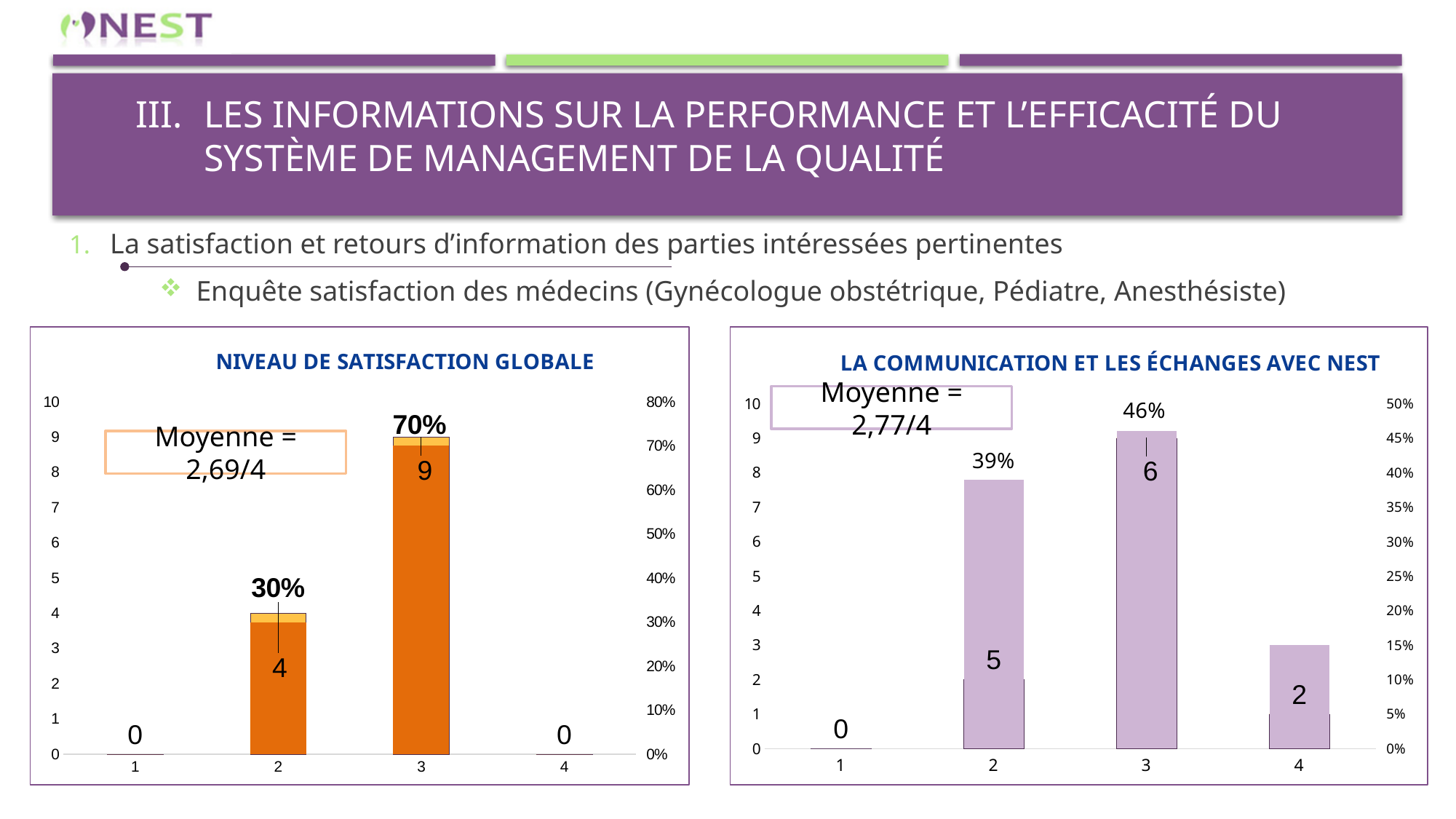
In the 'NIVEAU DE SATISFACTION GLOBALE' chart, what is the total of the counts across all four categories? 13 In the 'LA COMMUNICATION ET LES ÉCHANGES AVEC NEST' chart, which category has the highest count? 3 What type of chart is 'NIVEAU DE SATISFACTION GLOBALE'? bar chart What average (Moyenne) is shown in the box on the 'LA COMMUNICATION ET LES ÉCHANGES AVEC NEST' chart? 2,77/4 In the 'LA COMMUNICATION ET LES ÉCHANGES AVEC NEST' chart, what percentage is shown for category 3? 46% In the 'LA COMMUNICATION ET LES ÉCHANGES AVEC NEST' chart, is the count for category 4 larger or smaller than the count for category 2? smaller In the 'LA COMMUNICATION ET LES ÉCHANGES AVEC NEST' chart, what is the count for category 2? 5 In the 'NIVEAU DE SATISFACTION GLOBALE' chart, what is the difference between the counts for category 3 and category 2? 5 In the 'NIVEAU DE SATISFACTION GLOBALE' chart, what percentage is shown for category 2? 30% In the 'NIVEAU DE SATISFACTION GLOBALE' chart, which category has the highest count? 3 In the 'LA COMMUNICATION ET LES ÉCHANGES AVEC NEST' chart, how many categories are shown on the x axis? 4 In the 'NIVEAU DE SATISFACTION GLOBALE' chart, what is the count for category 3? 9